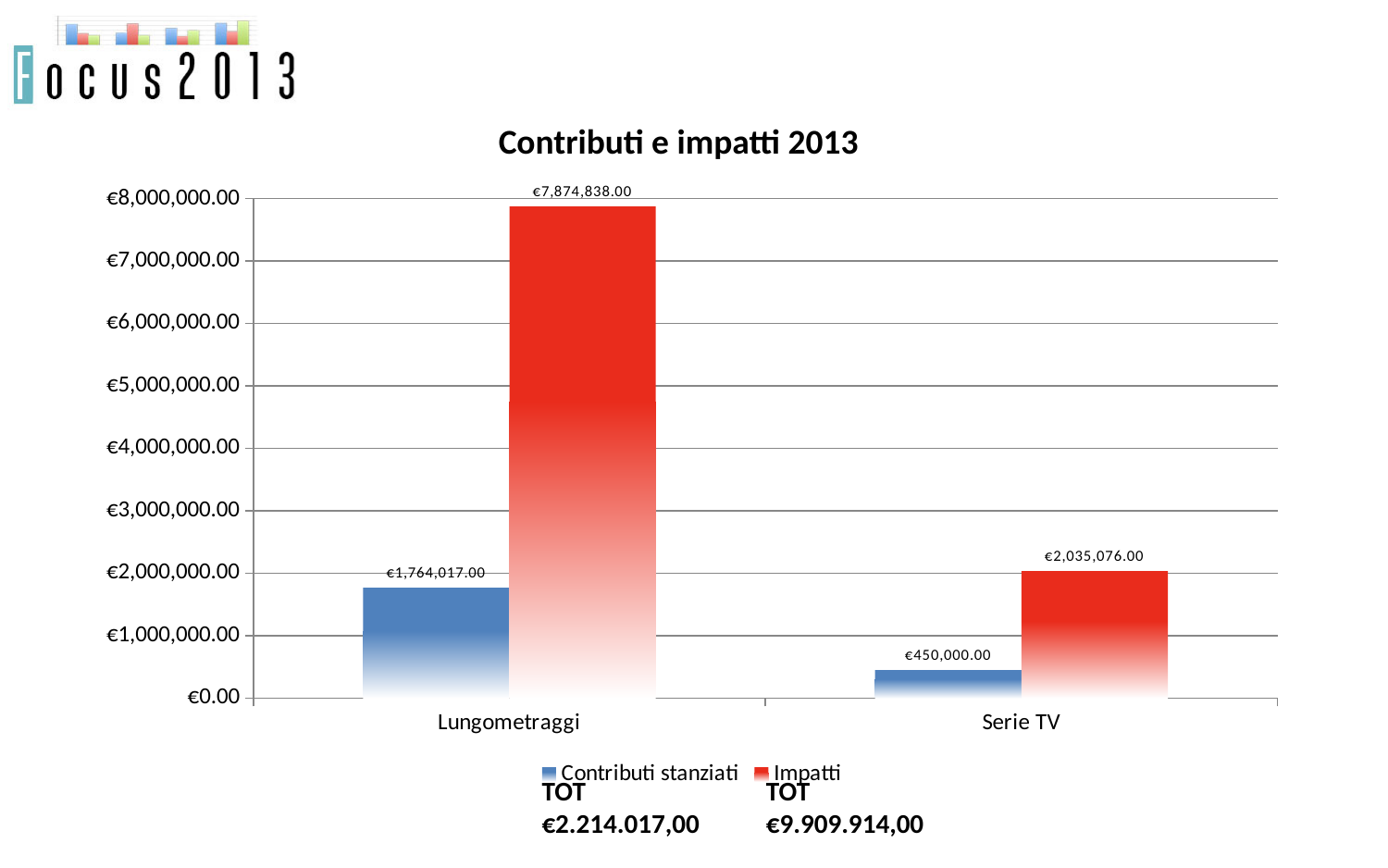
How many series does the legend list? 2 Which is larger: Contributi stanziati for Lungometraggi or Impatti for Serie TV? Impatti for Serie TV What is the difference between Impatti and Contributi stanziati for Lungometraggi? €6,110,821.00 What type of chart is shown on the slide? Bar chart Which category has the lowest Contributi stanziati value? Serie TV What is the value of Impatti for Serie TV? €2,035,076.00 What is the value of Impatti for Lungometraggi? €7,874,838.00 What is the value of Contributi stanziati for Serie TV? €450,000.00 Which category has the highest Impatti value? Lungometraggi What is the value of Contributi stanziati for Lungometraggi? €1,764,017.00 How many categories are shown on the x axis? 2 What is the difference between Impatti and Contributi stanziati for Serie TV? €1,585,076.00